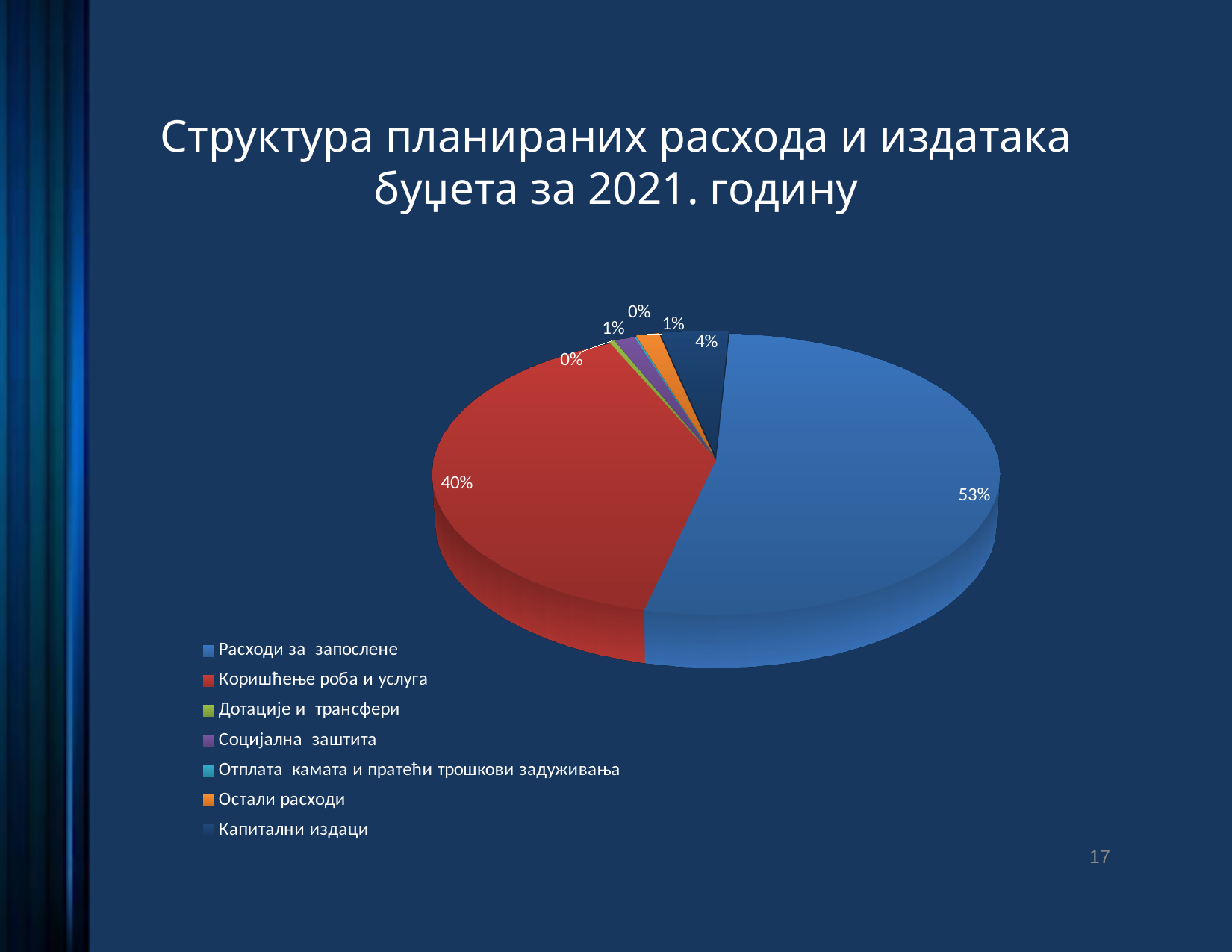
What share of the pie does Коришћење роба и услуга have? 40% What share of the pie does Расходи за запослене have? 53% What is the difference in percentage points between the Коришћење роба и услуга slice and the Капитални издаци slice? 36 What share of the pie does Капитални издаци have? 4% What is the difference in percentage points between the Расходи за запослене slice and the Коришћење роба и услуга slice? 13 Which is larger, the slice for Расходи за запослене or the slice for Коришћење роба и услуга? Расходи за запослене What kind of chart is shown on the slide? pie chart How many categories does the legend list? 7 What colour is the slice for Коришћење роба и услуга? red Which is larger, the slice for Капитални издаци or the slice for Остали расходи? Капитални издаци What is the title of the slide containing the chart? Структура планираних расхода и издатака буџета за 2021. годину Which category has the largest slice of the pie? Расходи за запослене